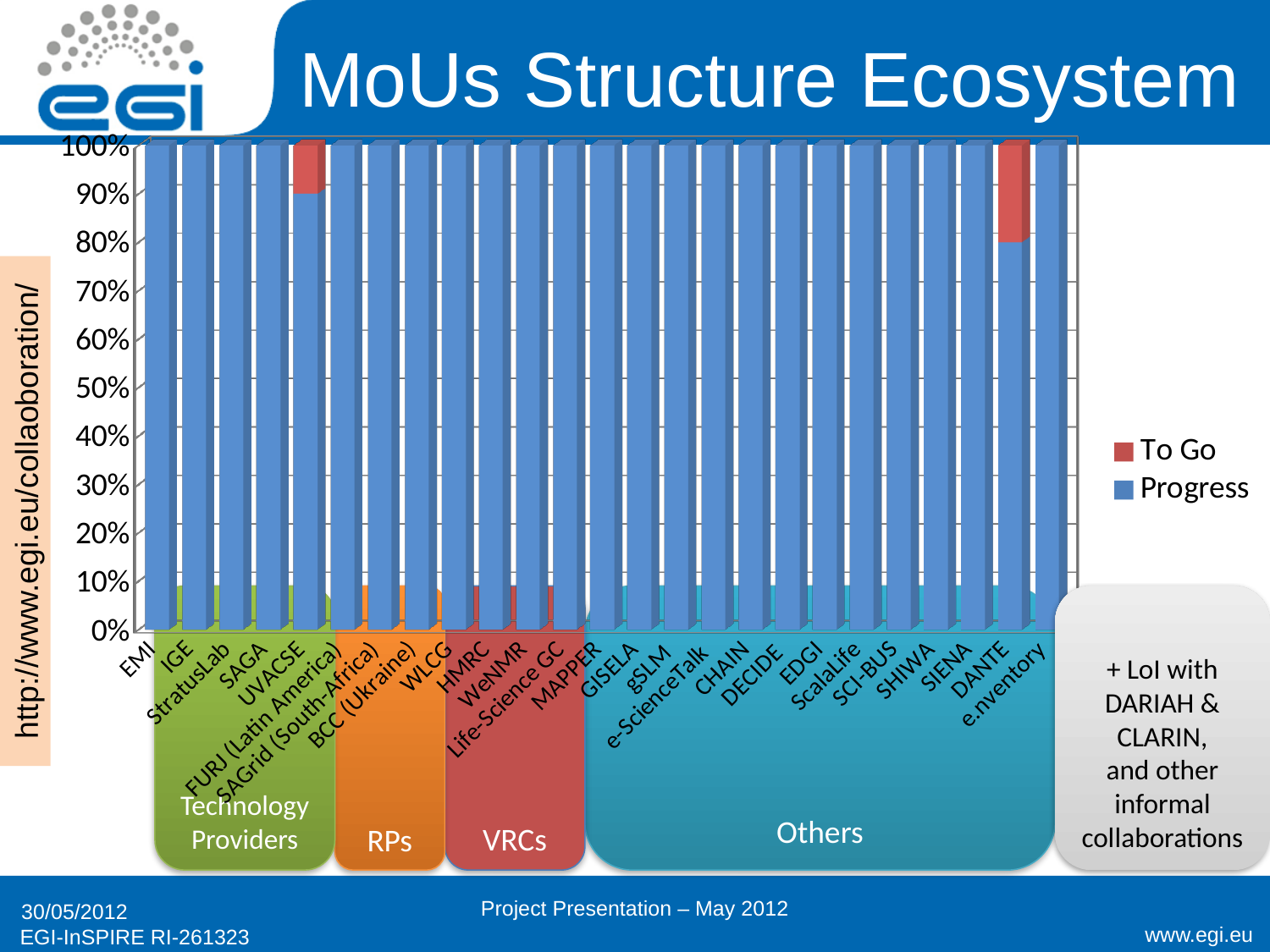
How many categories (bars) are plotted along the x axis of the chart? 25 What is the total of the stacked bar for WLCG? 100% What colour represents the To Go series in the chart? red Is the Progress value for UVACSE greater or less than 80%? greater What is the Progress value for EMI? 100% What are the two series named in the chart legend? To Go and Progress Is the Progress value for DANTE greater or less than 90%? less What is the Progress value for UVACSE? 90% What kind of chart is shown on the slide? bar chart How many series does the chart legend list? 2 Which has the larger To Go value, DANTE or UVACSE? DANTE Which category has the highest To Go value? DANTE